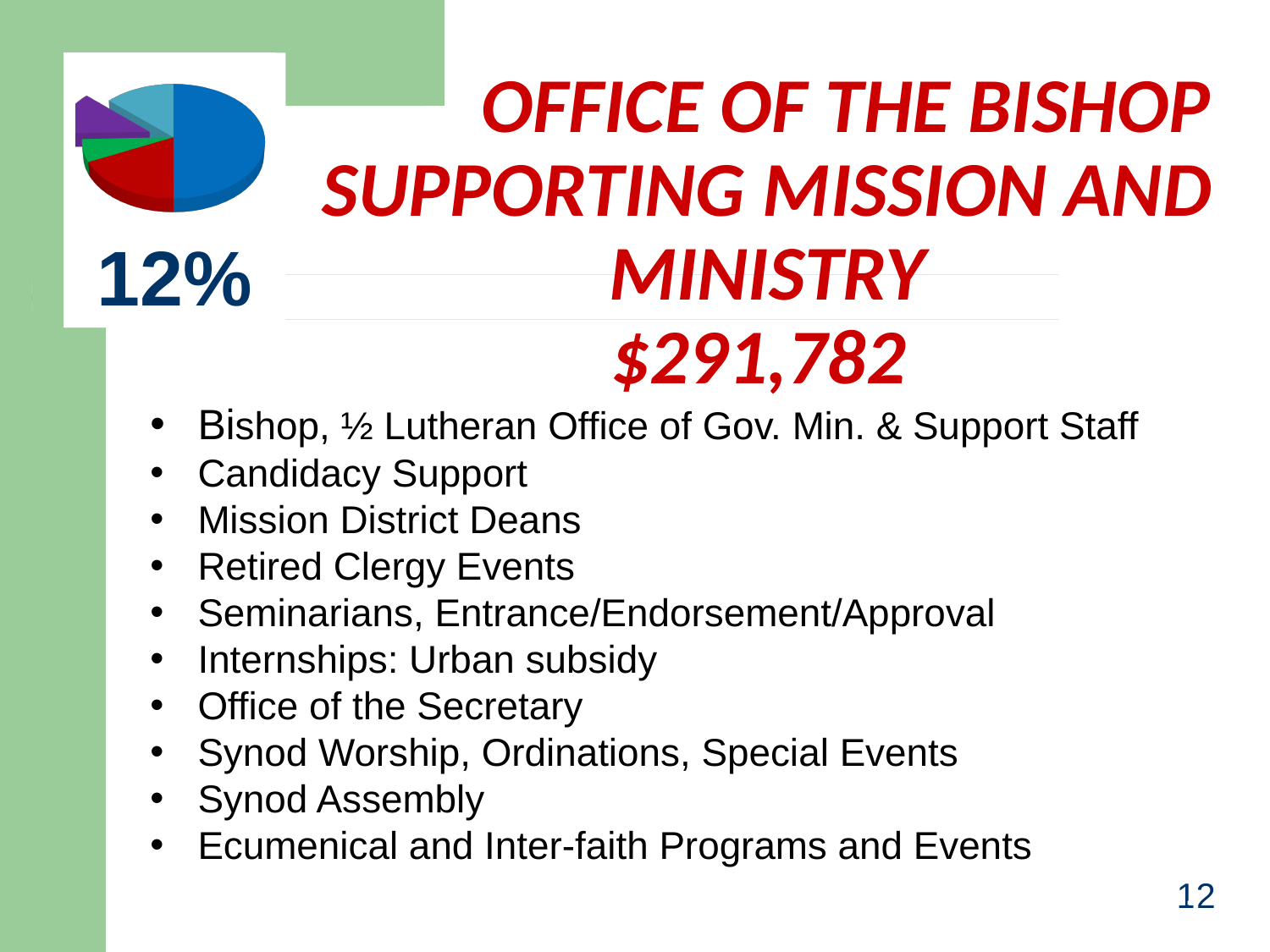
Which colour slice is the largest in the pie chart? blue Is the pie chart drawn in 3D or flat 2D? 3D Which colour slice is pulled out (exploded) from the pie chart? purple How many slices does the pie chart have? 5 What kind of chart is shown in the top-left corner of the slide? pie chart Does the pie chart include a legend? No What percentage is printed directly below the pie chart? 12%